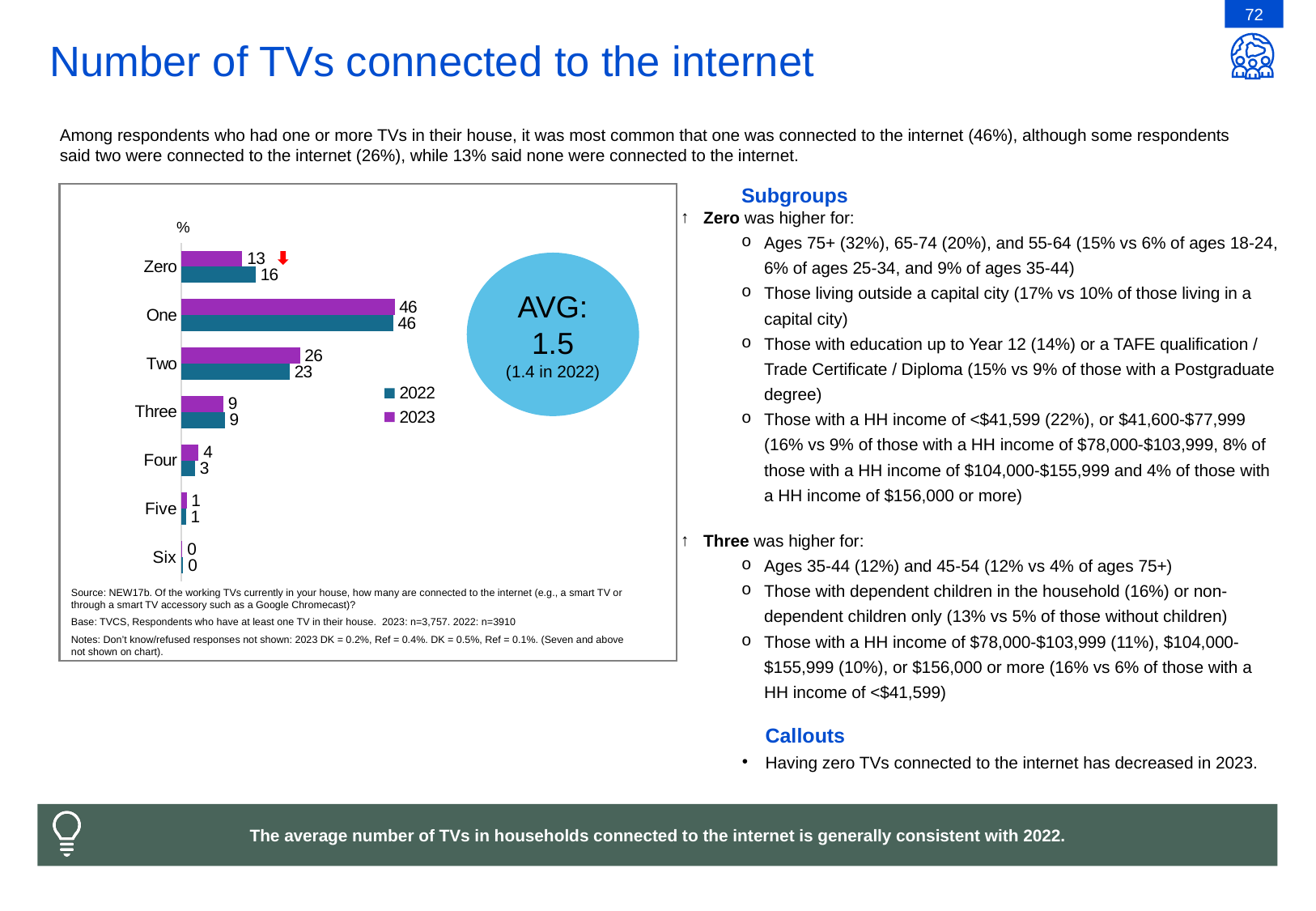
What is the difference between the 2022 and 2023 values for Zero? 3 What is the 2022 value for Two TVs connected to the internet? 23 What is the 2023 value for Zero TVs connected to the internet? 13 What average value is shown in the circle on the chart? 1.5 What is the 2023 value for Four TVs connected to the internet? 4 How many series does the legend list? 2 What kind of chart is shown on the slide? bar chart How many categories are shown on the chart? 7 Which category has the lowest value in 2022? Six What is the difference between the 2023 values for One and Two? 20 Is the 2023 value for Two larger or smaller than the 2022 value for Two? larger Which category has the highest value in 2023? One